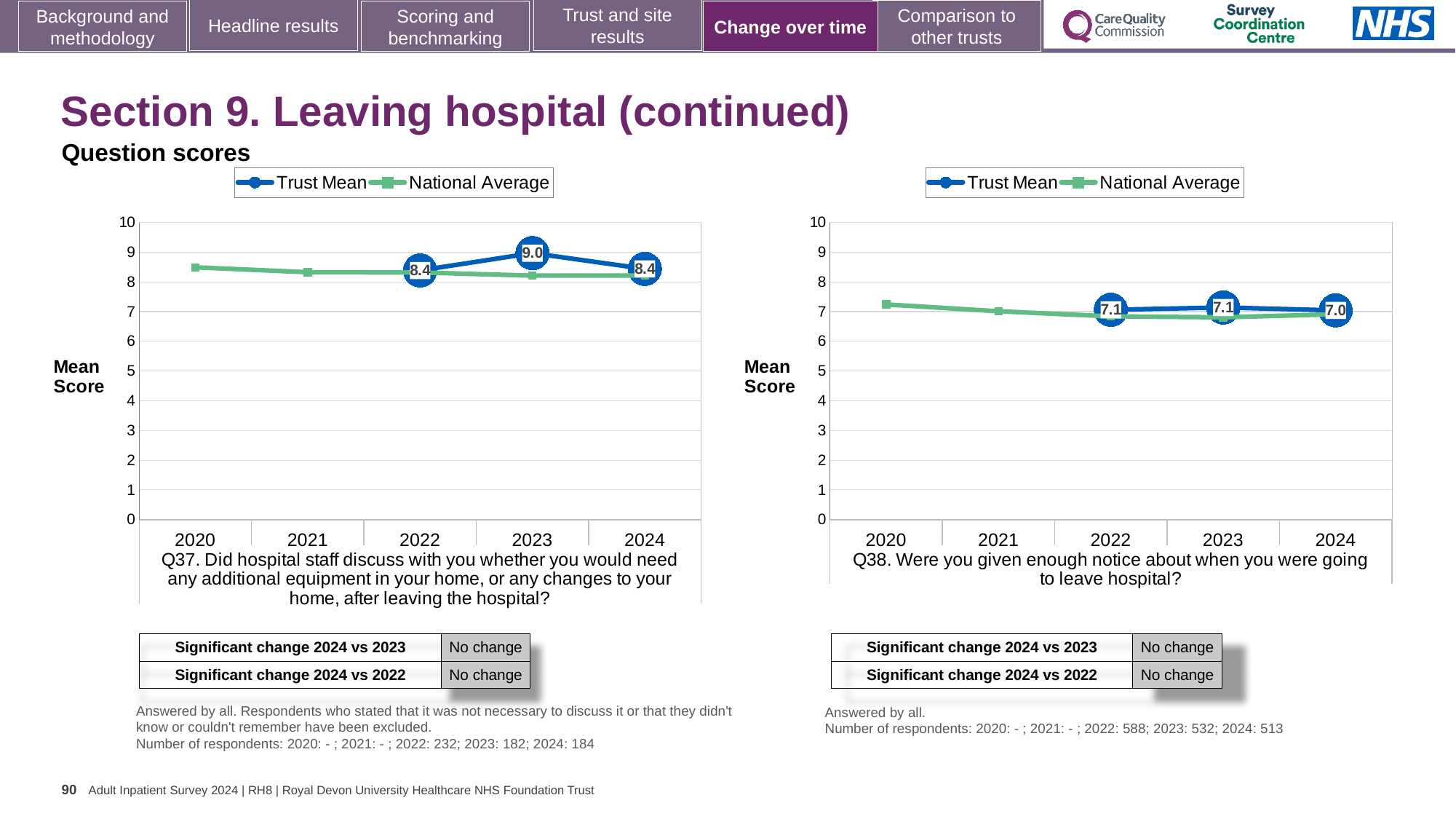
How many years are shown on the x axis of the Q38 chart (right)? 5 In the Q37 chart (left), what is the Trust Mean score for 2023? 9.0 In the Q37 chart (left), what is the difference between the Trust Mean scores for 2023 and 2022? 0.6 In the Q38 chart (right), what is the Trust Mean score for 2022? 7.1 How many series does the legend of the Q38 chart (right) list? 2 In the Q38 chart (right), what is the difference between the Trust Mean scores for 2023 and 2024? 0.1 In the Q38 chart (right), what is the Trust Mean score for 2024? 7.0 In the Q37 chart (left), what is the Trust Mean score for 2024? 8.4 What type of chart is the Q37 chart (left)? Line chart In the Q38 chart (right), is the National Average for 2020 greater or less than 8? less In the Q37 chart (left), is the Trust Mean score for 2023 greater or less than 8? greater In the Q37 chart (left), which year has the highest Trust Mean score? 2023